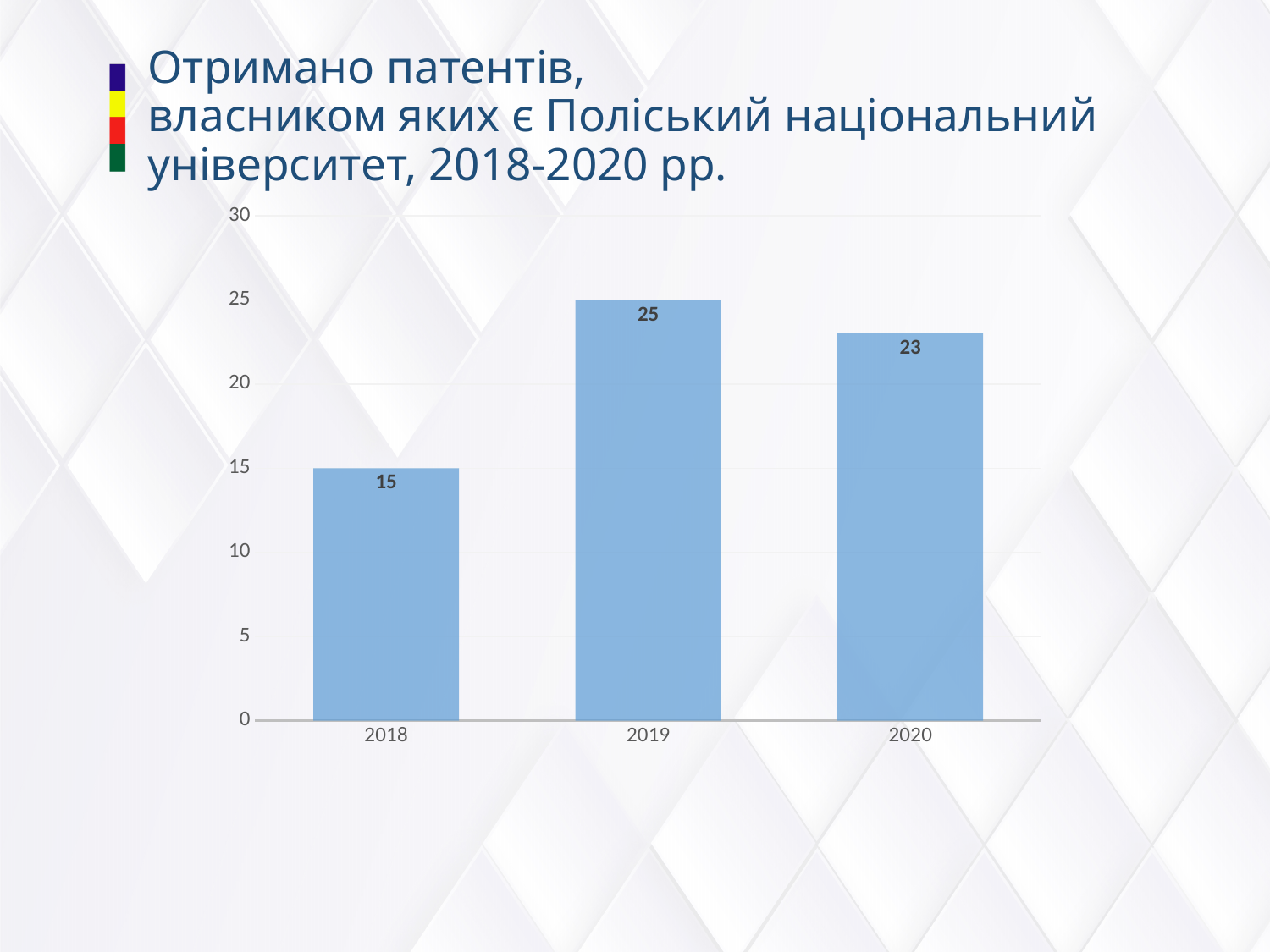
What is the difference between the values for 2019 and 2018? 10 What is the highest value shown on the vertical axis? 30 How many patents were obtained in 2018? 15 What is the difference between the values for 2019 and 2020? 2 What kind of chart is shown on the slide? bar chart Which year has the highest number of patents? 2019 How many years are shown on the x axis? 3 What is the value shown for 2019? 25 Which year has the lowest number of patents? 2018 What is the value shown for 2020? 23 Is the value for 2020 greater or less than 20? greater Which is larger, the value for 2020 or the value for 2018? 2020